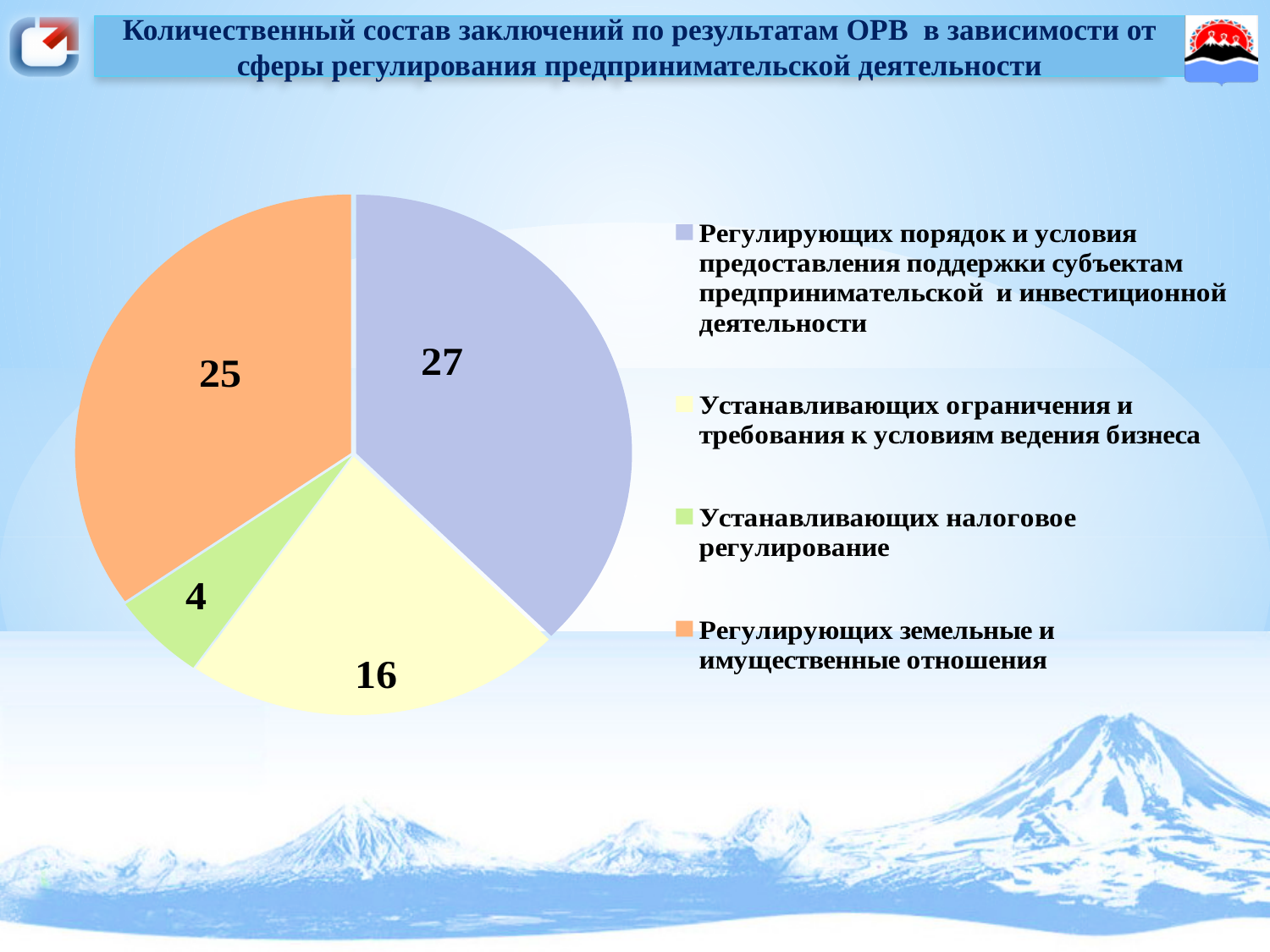
What is the value for «Устанавливающих ограничения и требования к условиям ведения бизнеса»? 16 How many slices does the pie chart have? 4 Which category has the largest slice of the pie chart? Регулирующих порядок и условия предоставления поддержки субъектам предпринимательской и инвестиционной деятельности What colour is the slice for «Регулирующих земельные и имущественные отношения»? orange How many entries does the legend of the pie chart list? 4 What kind of chart is shown on the slide? pie chart What is the difference between the values for «Регулирующих земельные и имущественные отношения» and «Устанавливающих ограничения и требования к условиям ведения бизнеса»? 9 What is the value for «Устанавливающих налоговое регулирование»? 4 Which is larger: the value for «Устанавливающих ограничения и требования к условиям ведения бизнеса» or the value for «Устанавливающих налоговое регулирование»? Устанавливающих ограничения и требования к условиям ведения бизнеса What is the value for «Регулирующих порядок и условия предоставления поддержки субъектам предпринимательской и инвестиционной деятельности»? 27 Which category has the smallest slice of the pie chart? Устанавливающих налоговое регулирование What is the value for «Регулирующих земельные и имущественные отношения»? 25